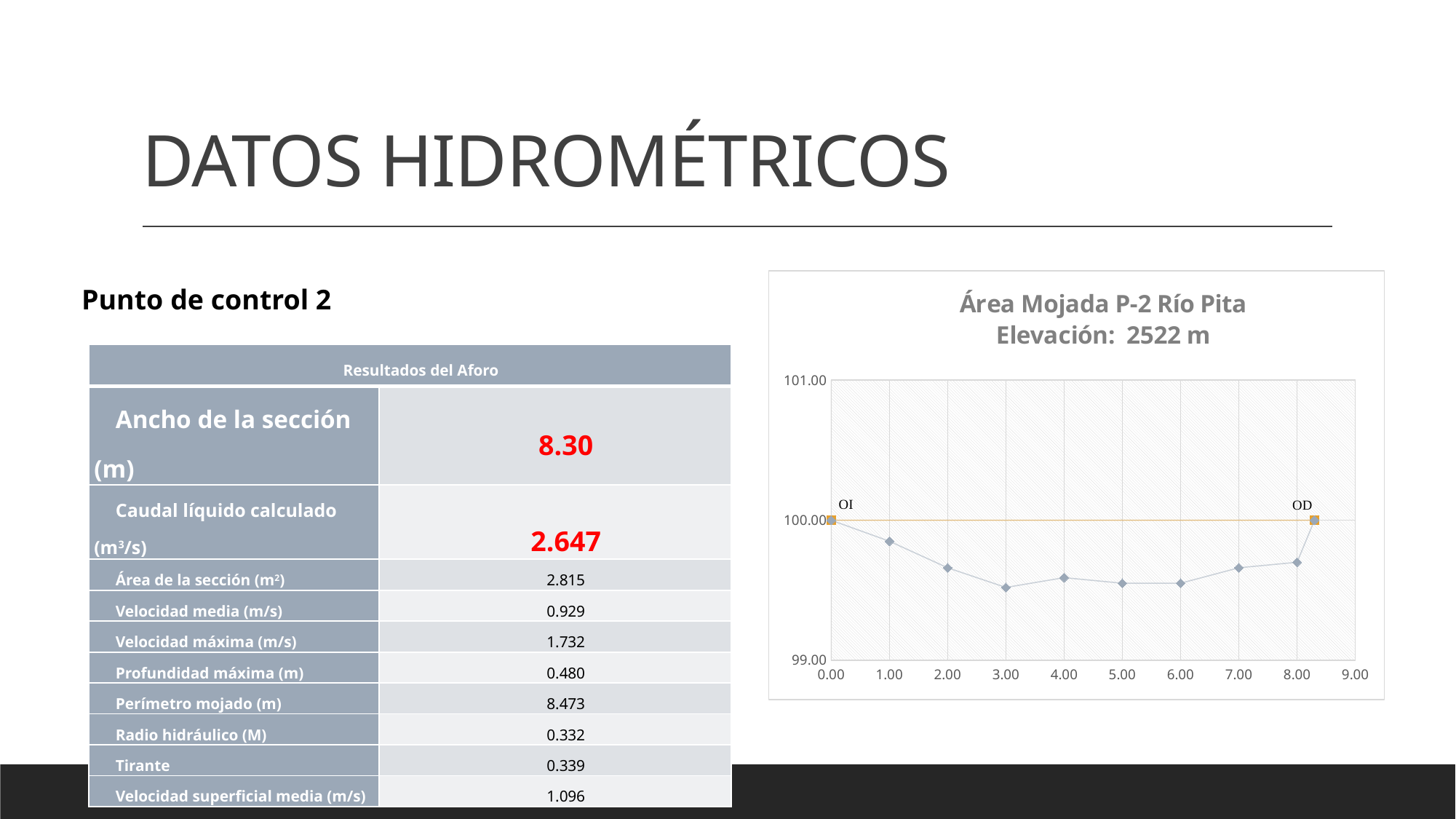
What are the two text labels shown on the chart's data points? OI and OD What kind of chart is shown on the slide? line chart At which x value does the profile reach its lowest point? 3.00 What is the y value of the point labelled OI? 100.00 Which is larger, the value at x = 1.00 or the value at x = 3.00? x = 1.00 What is the y value of the point labelled OD? 100.00 Do the values rise or fall along the x axis from 6.00 to the OD point? rise Do the values rise or fall along the x axis from 0.00 to 3.00? fall Which is larger, the value at x = 8.00 or the value at x = 5.00? x = 8.00 Is the value at x = 1.00 greater or less than 100.00? less What is the title of the chart? Área Mojada P-2 Río Pita Elevación: 2522 m Is the value at x = 3.00 greater or less than 100.00? less